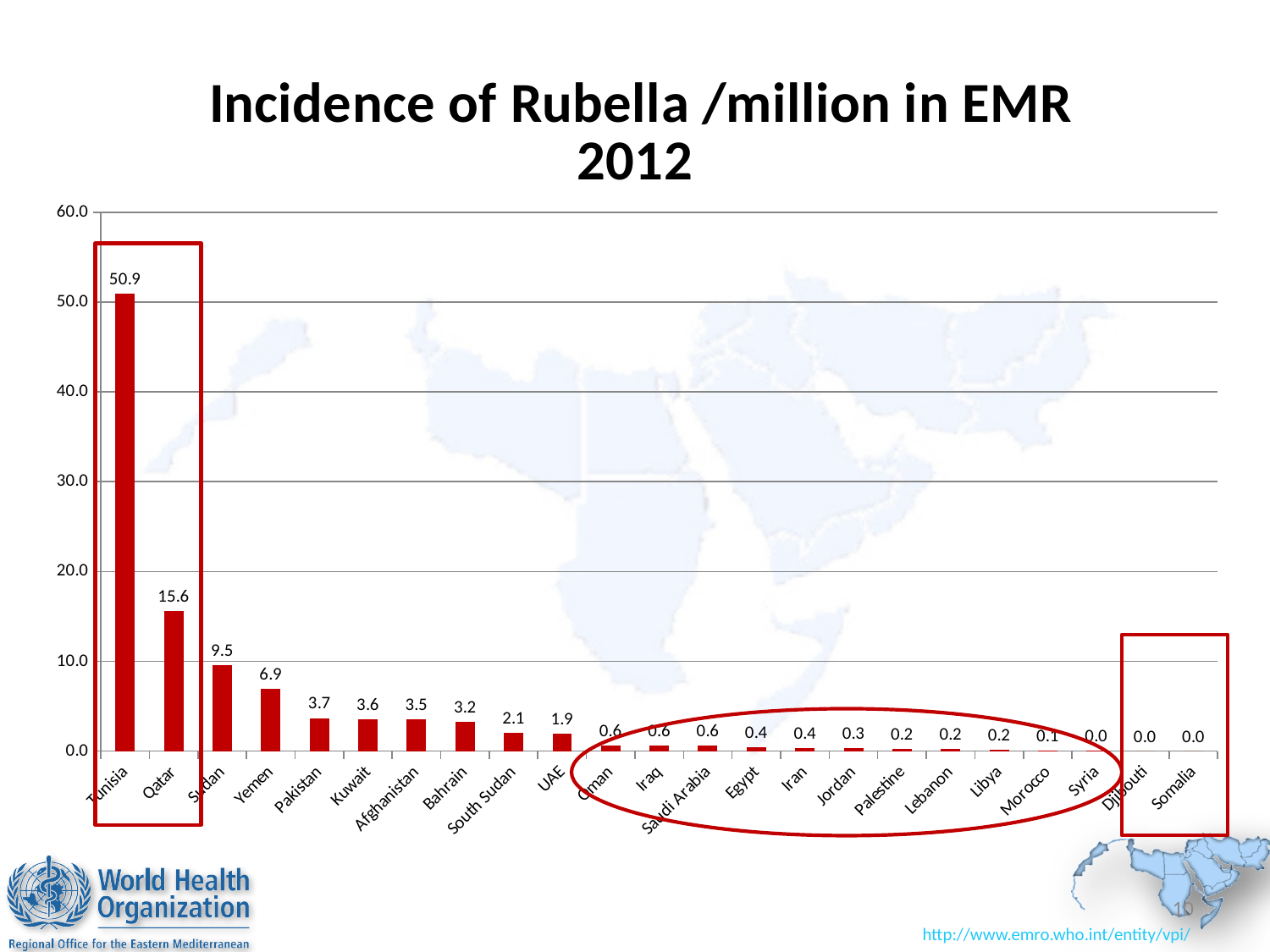
What is the value shown for Pakistan? 3.7 What is the value shown for Qatar? 15.6 Which country has the highest rubella incidence per million? Tunisia Is the value for Qatar greater or less than 10.0? greater Do the values rise or fall moving from left to right along the x axis? fall What is the value shown for Morocco? 0.1 How many countries are shown on the x axis? 23 What is the value shown for Sudan? 9.5 What kind of chart is shown on the slide? bar chart What is the difference between the values for Tunisia and Qatar? 35.3 What is the rubella incidence per million for Tunisia? 50.9 Which has a higher value, Sudan or Yemen? Sudan